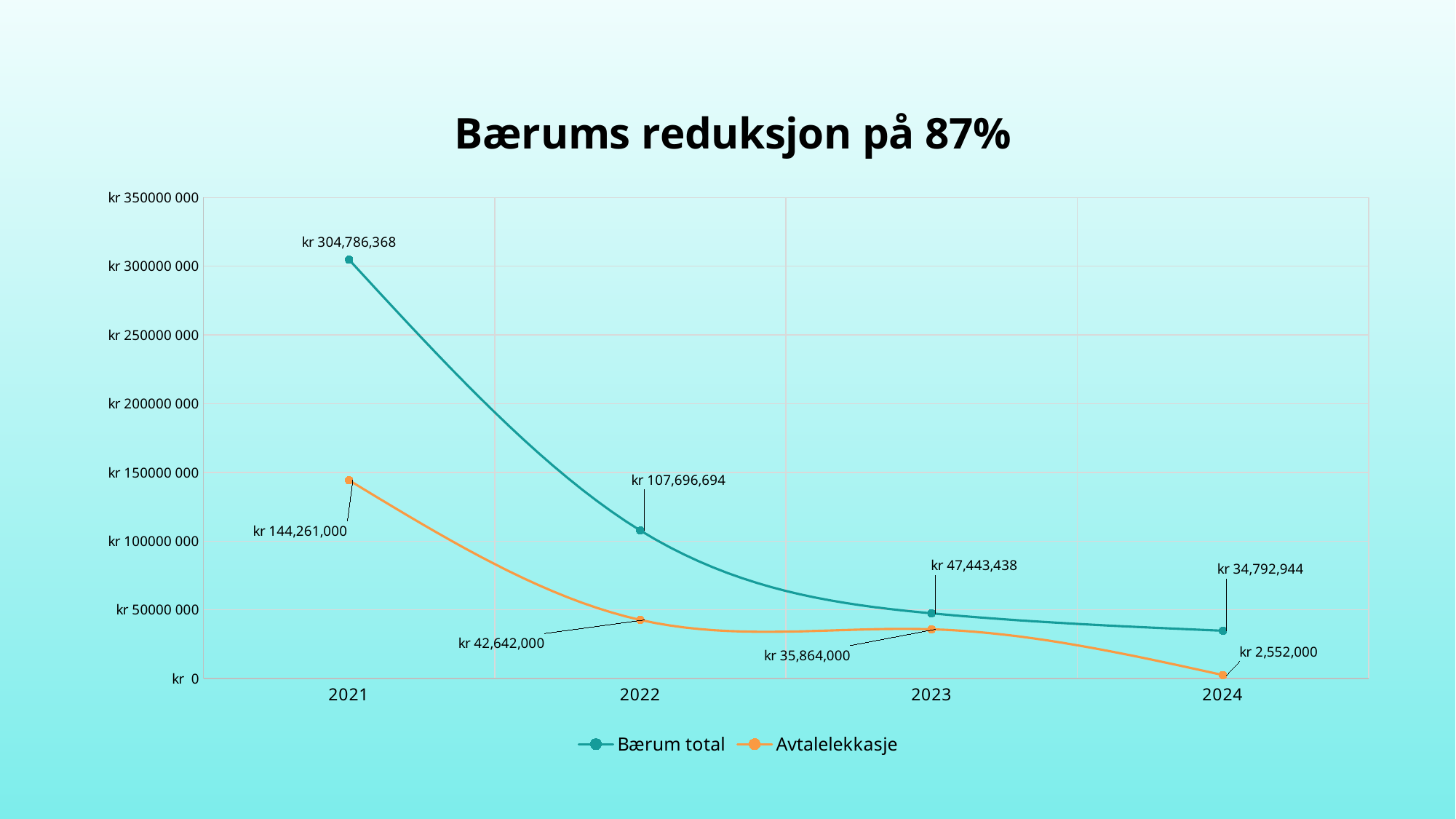
How many years are plotted along the x axis? 4 What is the value for Avtalelekkasje in 2022? kr 42,642,000 In which year is Avtalelekkasje at its highest? 2021 How many series does the legend list? 2 What is the value for Avtalelekkasje in 2024? kr 2,552,000 What type of chart is shown on the slide? Line chart In which year is Bærum total at its lowest? 2024 What is the value for Bærum total in 2023? kr 47,443,438 What is the title of the chart? Bærums reduksjon på 87% What is the value for Bærum total in 2021? kr 304,786,368 What is the difference between Bærum total and Avtalelekkasje in 2021? kr 160,525,368 Does the Bærum total series rise or fall from 2021 to 2024? Fall